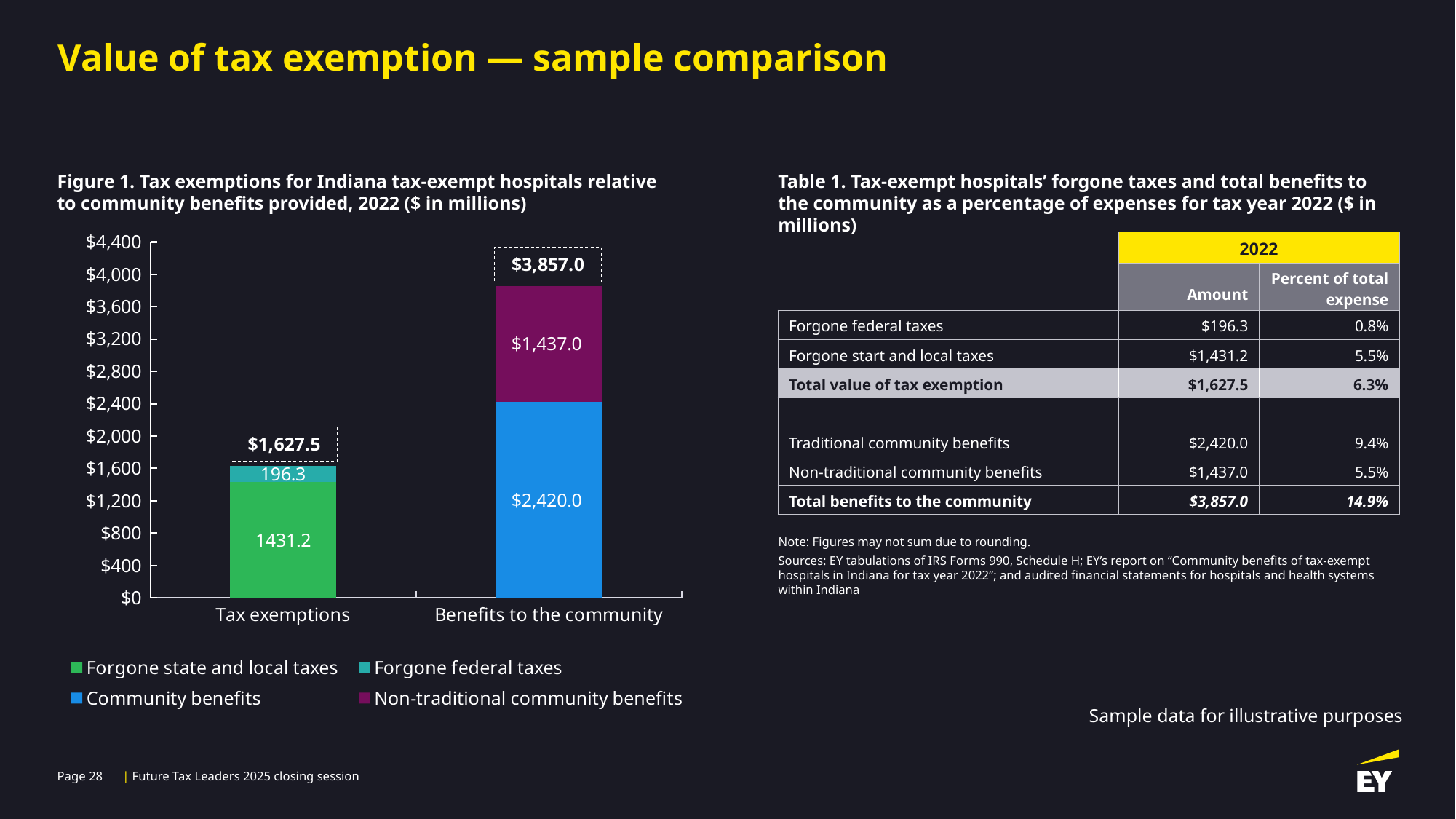
What kind of chart is shown in Figure 1? Stacked bar chart How many categories are shown on the x axis of the chart? 2 What is the value of Community benefits in the Benefits to the community bar? $2,420.0 What is the value of Non-traditional community benefits in the Benefits to the community bar? $1,437.0 What is the total of the Tax exemptions stacked bar? $1,627.5 What is the difference between the total of the Benefits to the community bar and the total of the Tax exemptions bar? $2,229.5 Is the total of the Tax exemptions bar greater or less than $2,000? less What is the value of Forgone state and local taxes in the Tax exemptions bar? 1431.2 What is the total of the Benefits to the community stacked bar? $3,857.0 What is the value of Forgone federal taxes in the Tax exemptions bar? 196.3 How many series does the chart legend list? 4 Which bar is taller, Tax exemptions or Benefits to the community? Benefits to the community